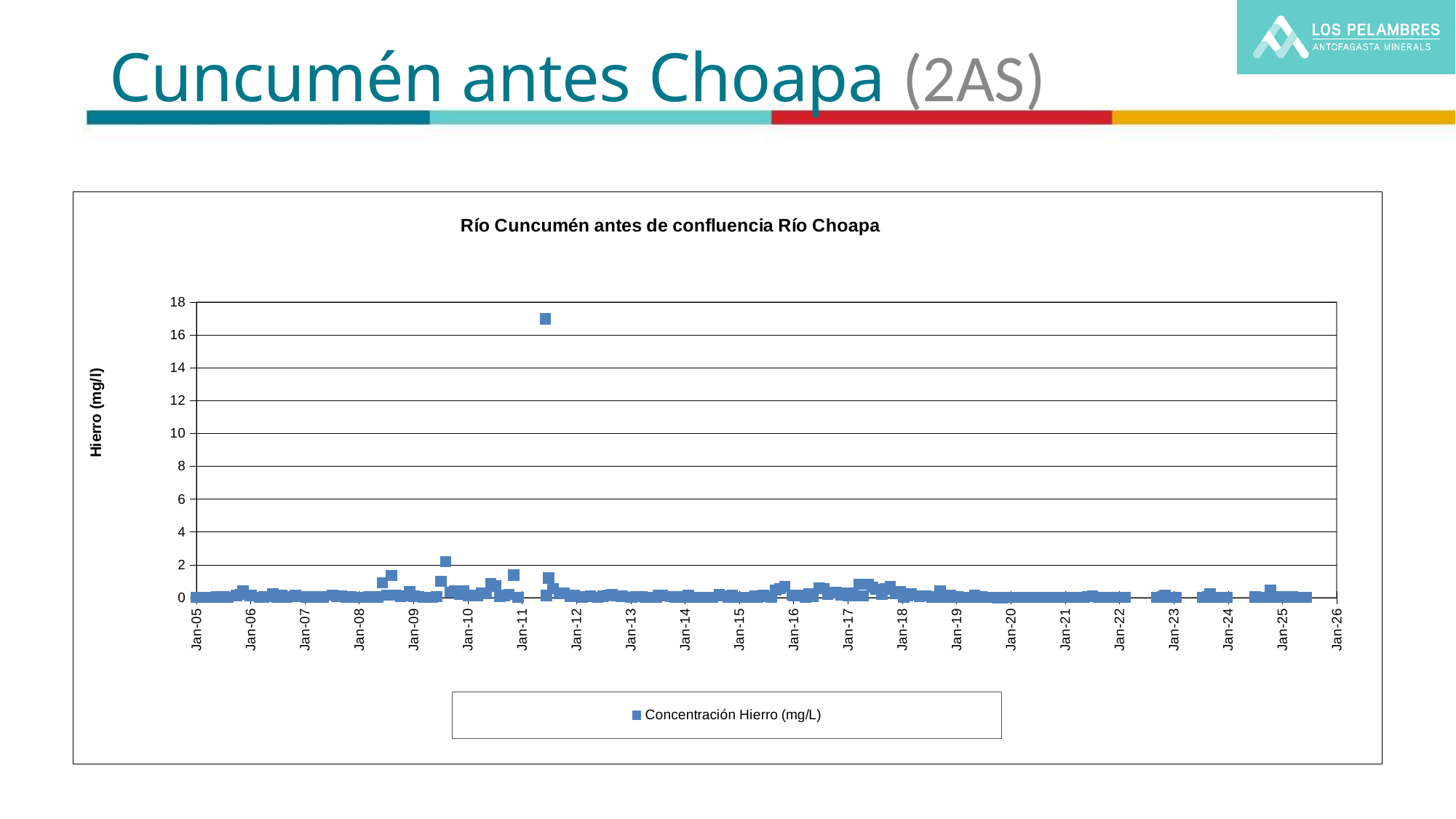
What is the first date label on the horizontal axis? Jan-05 Is the iron concentration at Jan-14 greater or less than 4? less Is the iron concentration at Jan-20 greater or less than 2? less Is the highest plotted iron concentration value greater or less than 16? greater What is the title of the chart? Río Cuncumén antes de confluencia Río Choapa What is the label of the vertical axis? Hierro (mg/l) What is the name of the series shown in the legend? Concentración Hierro (mg/L) What is the last date label on the horizontal axis? Jan-26 Around which year does the highest iron concentration point occur? 2011 How many series does the chart legend list? 1 What kind of chart is shown on the slide? scatter chart What is the highest value shown on the vertical axis? 18